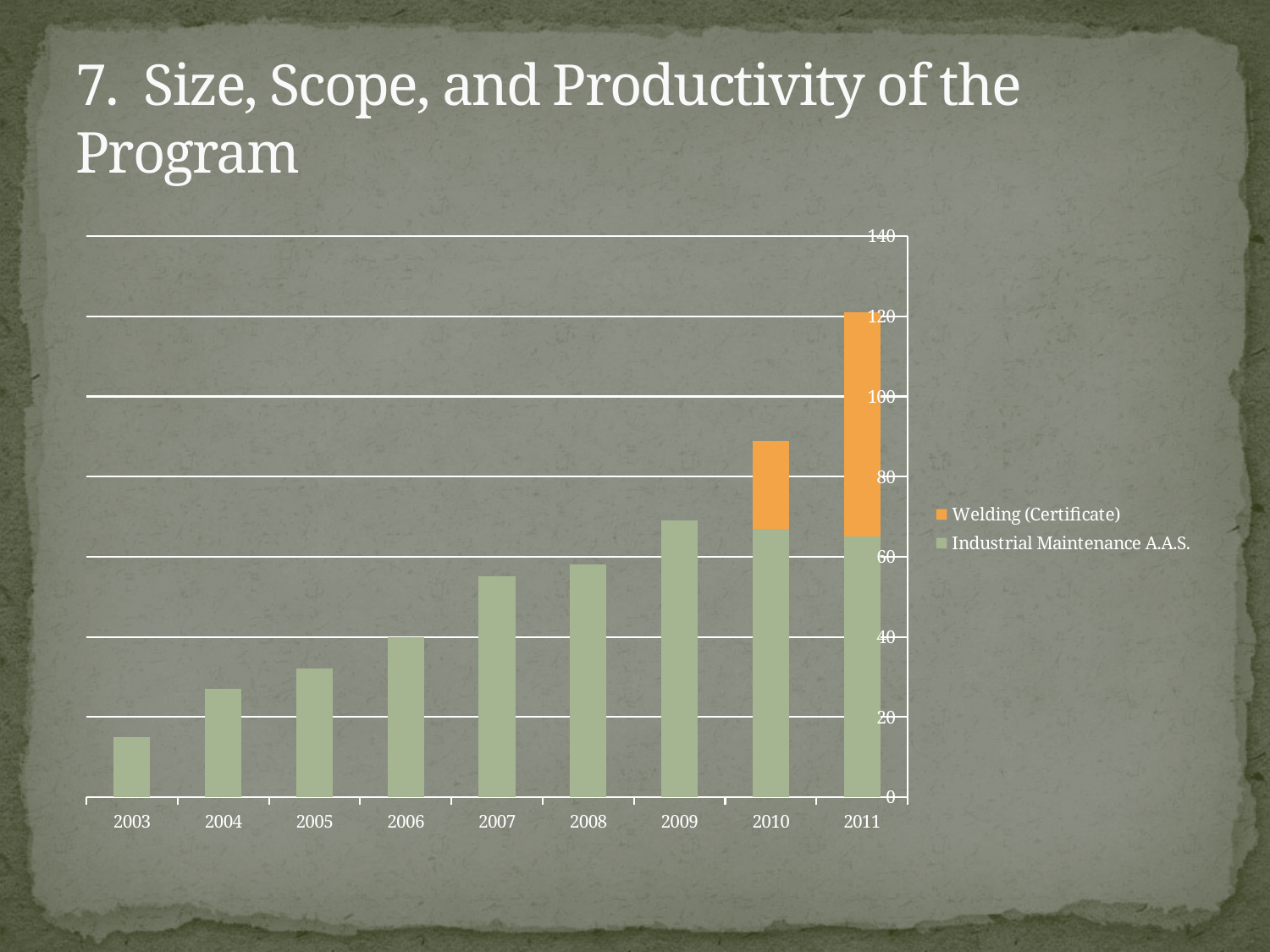
Which is larger, the bar for 2009 or the bar for 2004? 2009 How many series does the legend list? 2 Which year has the shortest bar? 2003 Which series is shown in orange in the legend? Welding (Certificate) Is the value for 2003 greater or less than 20? less Is the total of the 2010 stacked bar greater or less than 80? greater Is the total of the 2011 stacked bar greater or less than 100? greater Which year has the tallest stacked bar? 2011 How many years are shown on the x axis? 9 Do the bar totals generally rise or fall from 2003 to 2011? rise What kind of chart is shown on the slide? bar chart